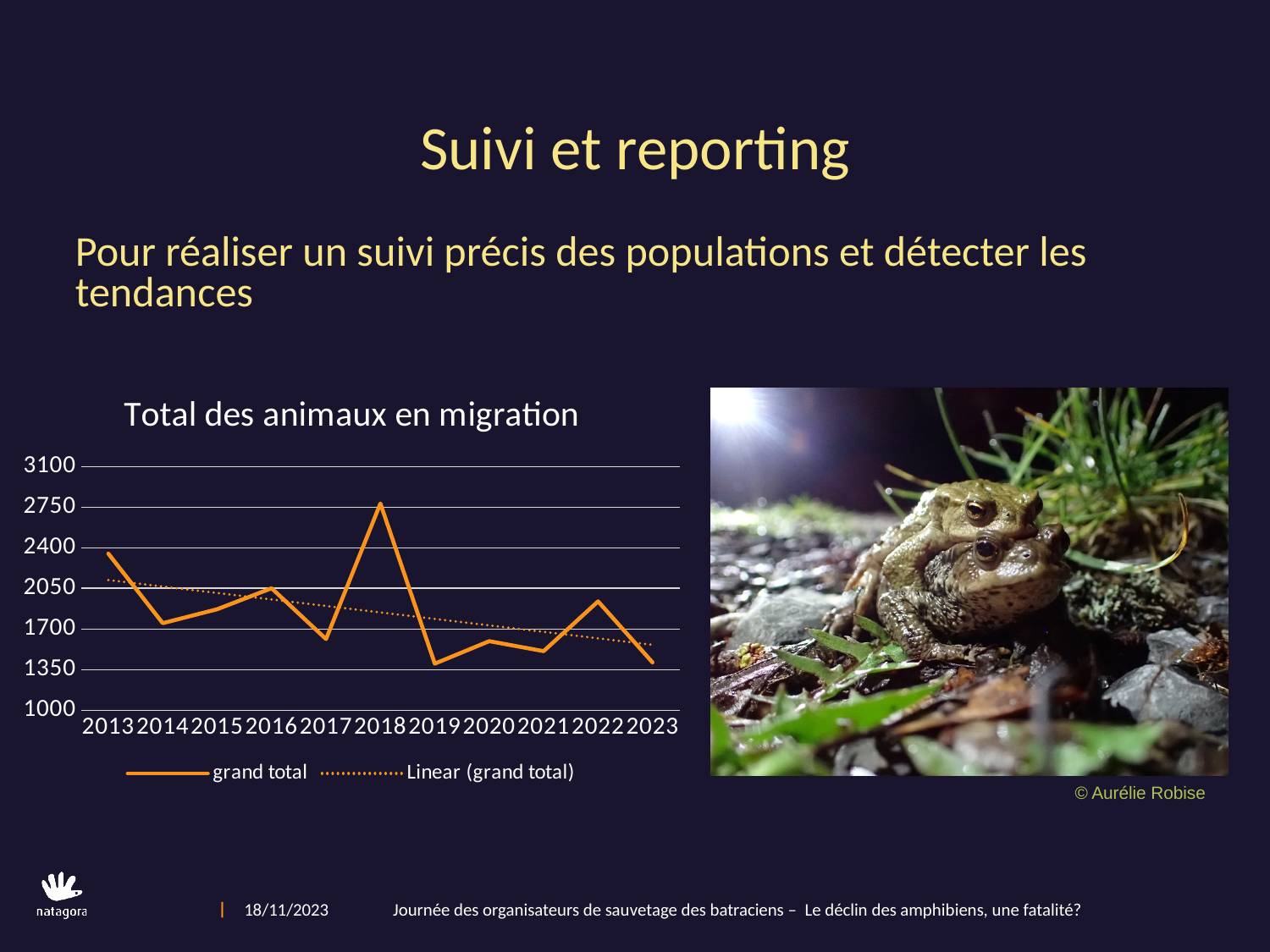
In which year is the grand total highest? 2018 Which year has the larger grand total, 2016 or 2017? 2016 Is the grand total for 2013 greater or less than 2050? greater What kind of chart is shown on the slide? line chart Which year has the larger grand total, 2013 or 2014? 2013 Is the grand total for 2019 greater or less than 1700? less What is the title of the chart on the slide? Total des animaux en migration Does the linear trendline for the grand total rise or fall from 2013 to 2023? fall Is the grand total for 2018 greater or less than 2400? greater How many years are plotted along the x axis of the chart? 11 How many series does the chart legend list? 2